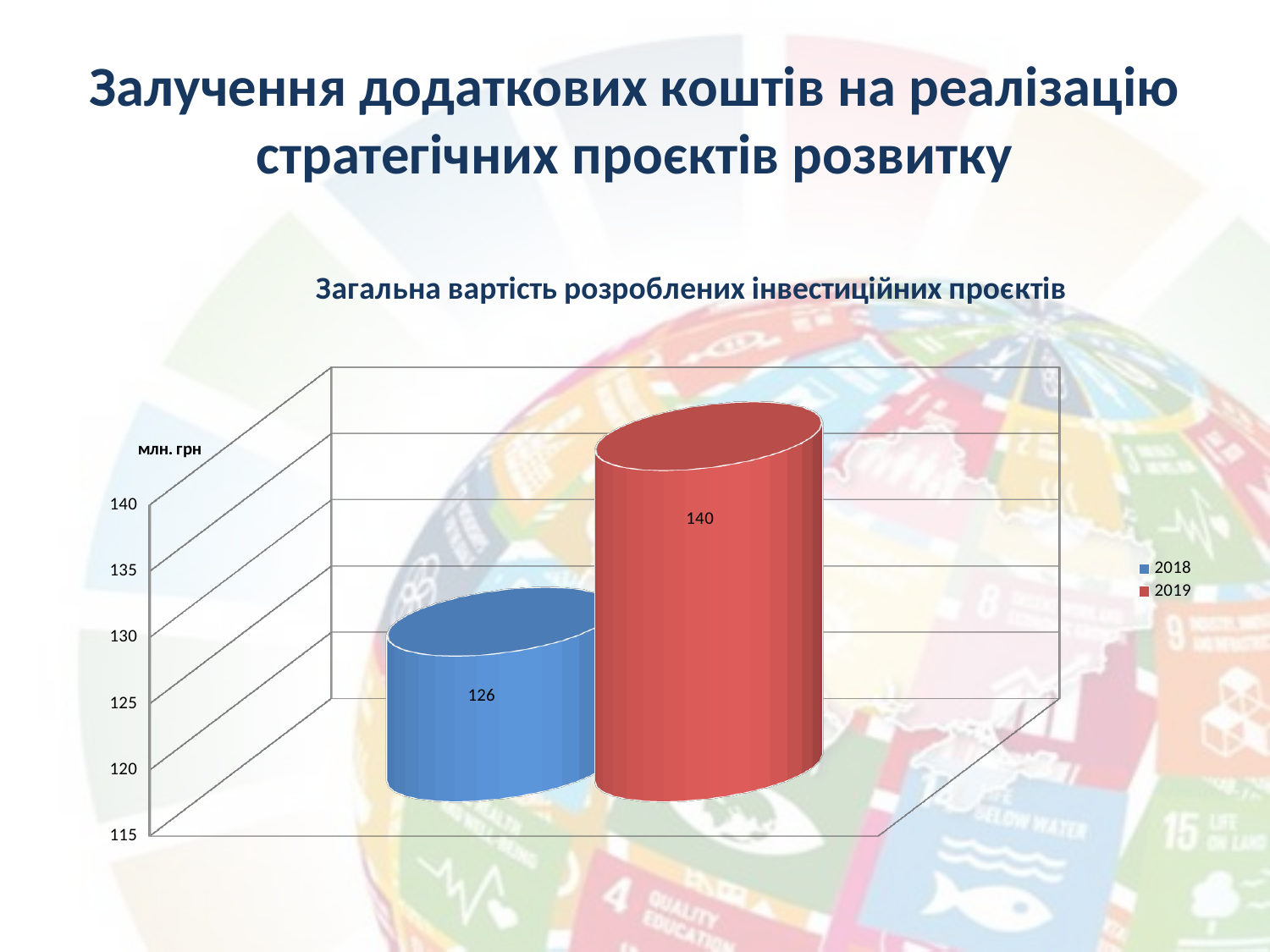
What kind of chart is shown? Bar chart Which year has the higher value? 2019 Is the value for 2018 greater or less than 130? less What unit is shown on the chart's axis label? млн. грн What is the value for 2018? 126 How many series does the legend list? 2 Is the value for 2019 larger than the value for 2018? Yes What is the difference between the 2019 and 2018 values? 14 What is the value for 2019? 140 Do the values rise or fall from 2018 to 2019? Rise What is the title of the chart? Загальна вартість розроблених інвестиційних проєктів Which year has the lower value? 2018